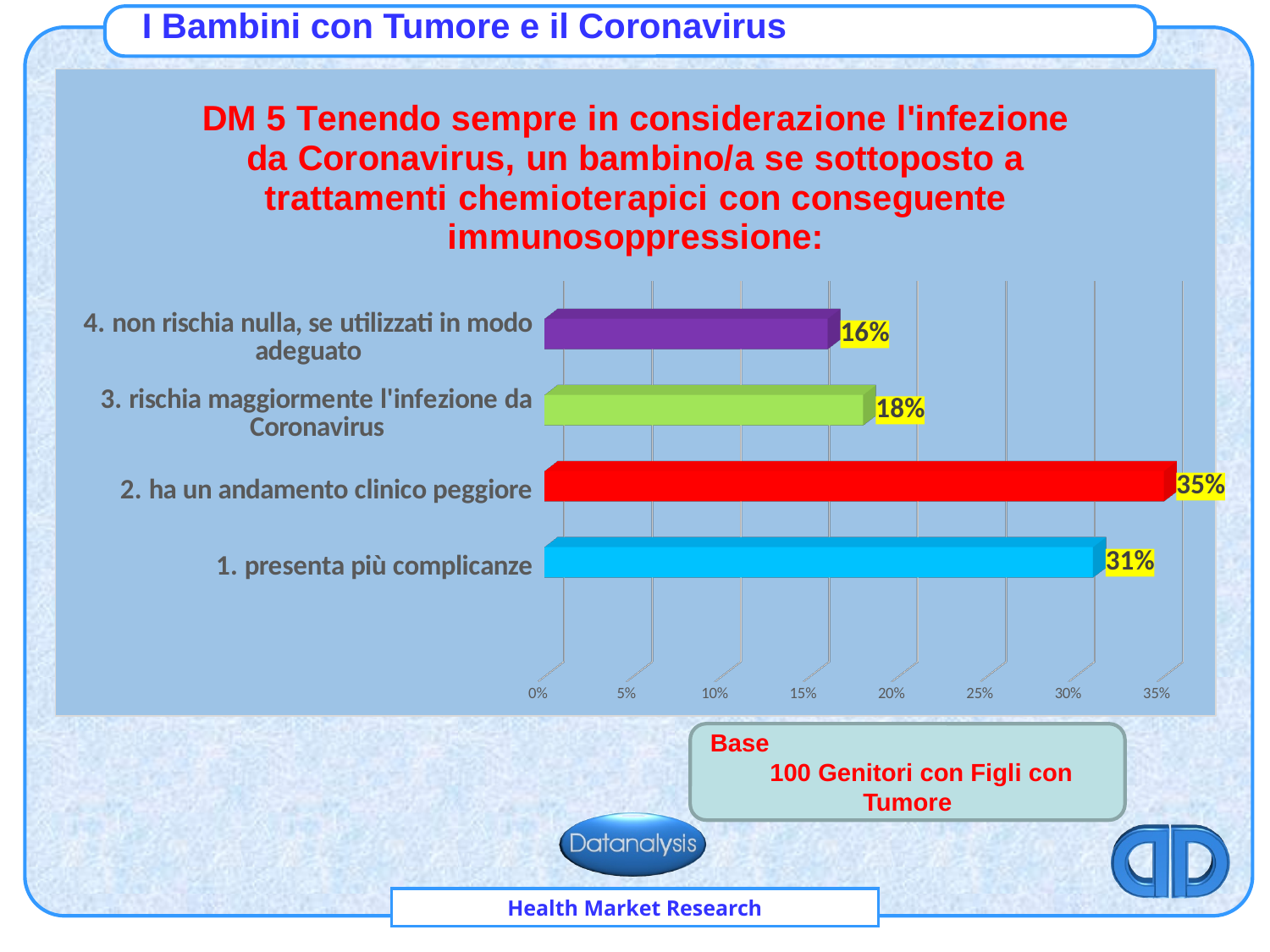
What is the value for "4. non rischia nulla, se utilizzati in modo adeguato"? 16% Which category has the lowest value? 4. non rischia nulla, se utilizzati in modo adeguato What colour is the bar for "2. ha un andamento clinico peggiore"? red What is the value for "3. rischia maggiormente l'infezione da Coronavirus"? 18% Which category has the highest value? 2. ha un andamento clinico peggiore What is the value for "2. ha un andamento clinico peggiore"? 35% What kind of chart is shown on the slide? bar chart What is the difference between the values for "2. ha un andamento clinico peggiore" and "1. presenta più complicanze"? 4% Which is larger: the value for "3. rischia maggiormente l'infezione da Coronavirus" or for "4. non rischia nulla, se utilizzati in modo adeguato"? 3. rischia maggiormente l'infezione da Coronavirus What is the value for "1. presenta più complicanze"? 31% Is the value for "1. presenta più complicanze" greater or less than 30%? greater How many categories are shown in the chart? 4